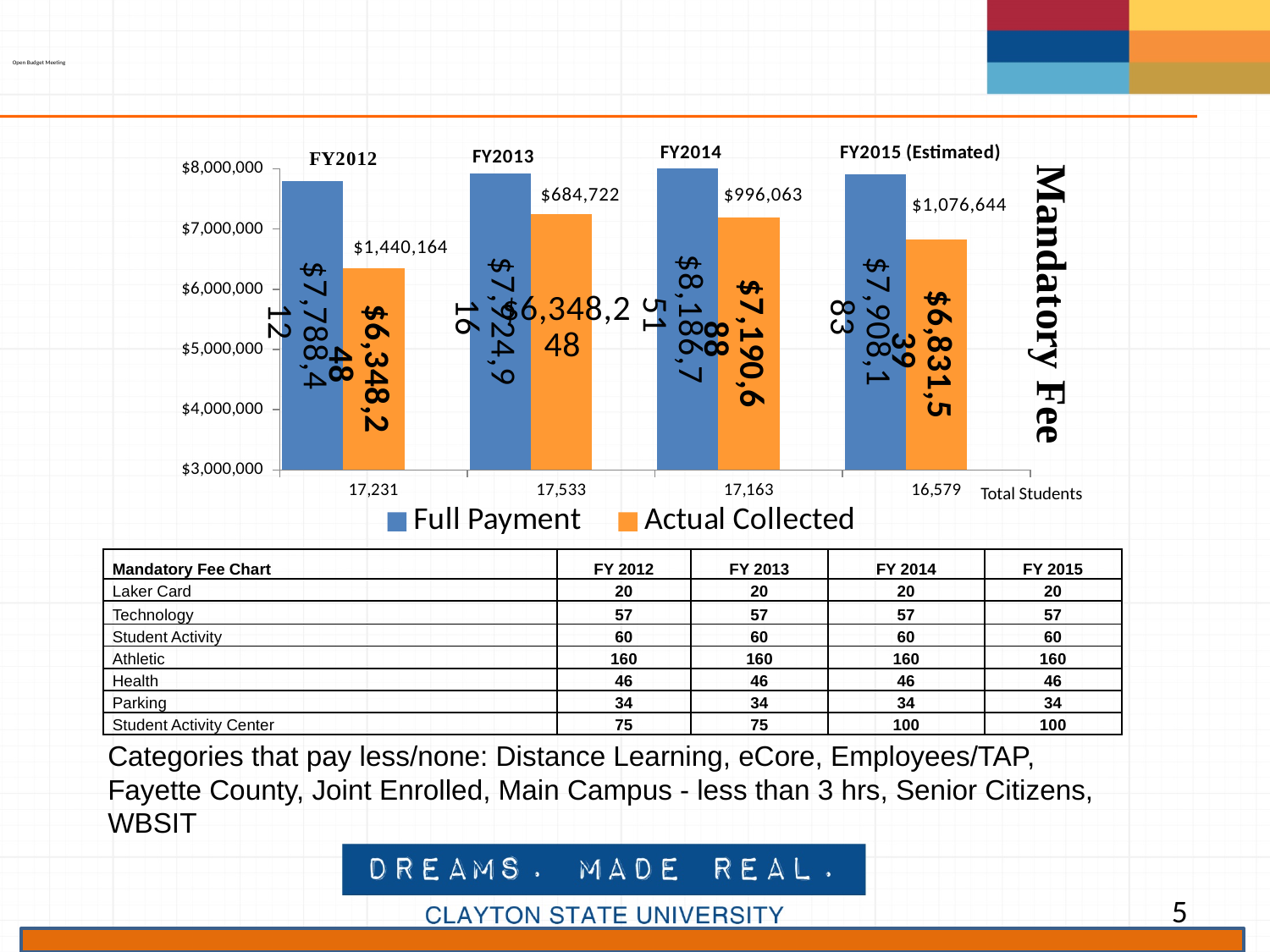
How many fiscal years are plotted on the chart? 4 What value is printed above the Actual Collected bar for FY2015 (Estimated)? $1,076,644 What value is printed above the Actual Collected bar for FY2014? $996,063 What is the title of the chart? Mandatory Fee What kind of chart is shown on the slide? bar chart Which fiscal year has the lowest Actual Collected bar? FY2012 What are the two series named in the chart legend? Full Payment and Actual Collected What is the Total Students figure shown under FY2013? 17,533 How many series does the chart legend list? 2 Is the Actual Collected value for FY2012 greater or less than $7,000,000? less Which fiscal year has the tallest Full Payment bar? FY2014 What value is printed above the Actual Collected bar for FY2012? $1,440,164